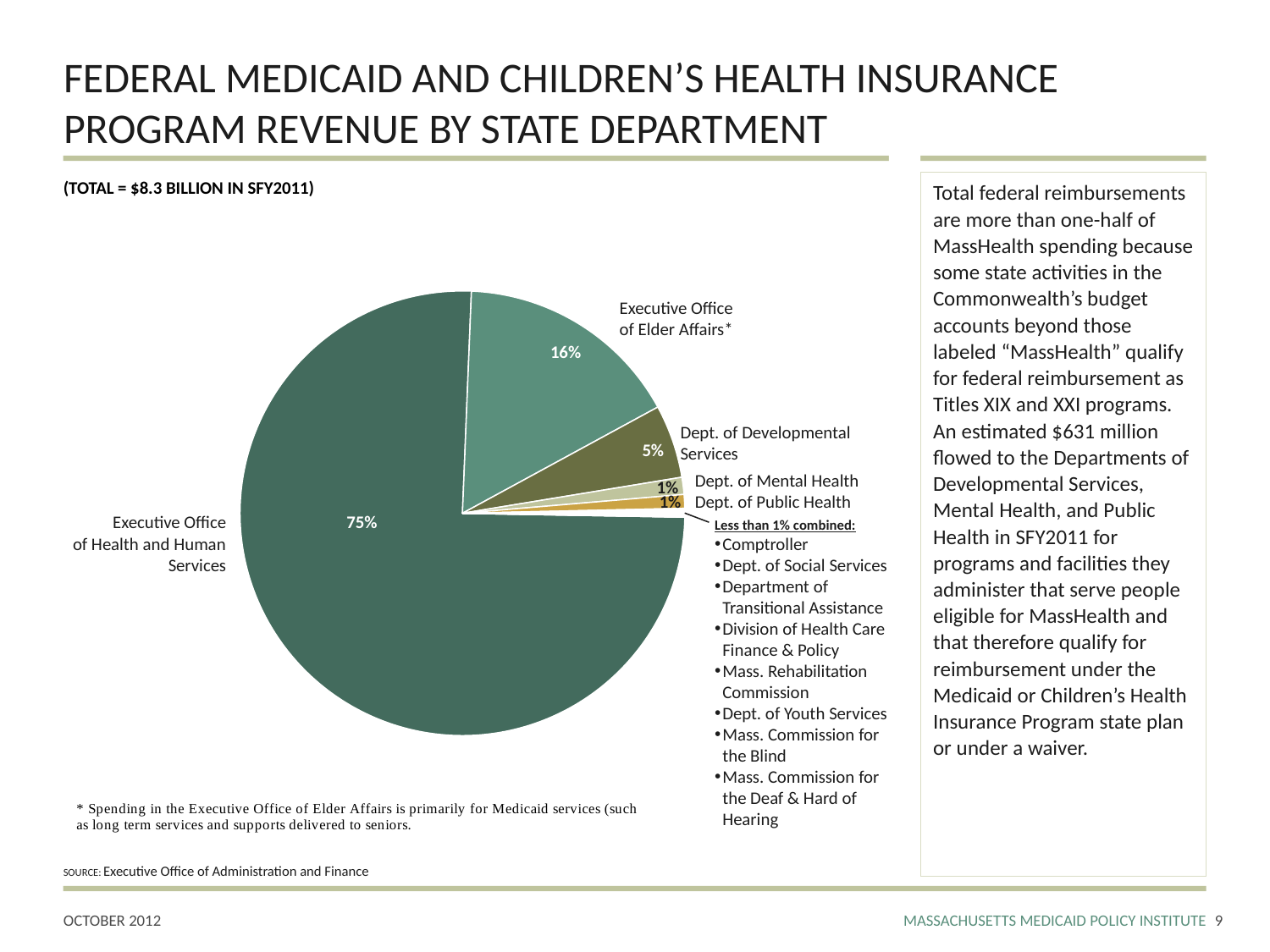
What kind of chart is shown on the slide? Pie chart Which department has the largest slice of the pie? Executive Office of Health and Human Services Which has a larger share: the Executive Office of Elder Affairs or the Dept. of Developmental Services? Executive Office of Elder Affairs What share of the pie does the Executive Office of Health and Human Services account for? 75% What is the difference in percentage points between the Executive Office of Elder Affairs and the Dept. of Developmental Services? 11 percentage points What percentage is shown for the Dept. of Developmental Services? 5% What total amount does the chart subtitle state for SFY2011? $8.3 billion How many slices of the pie have a percentage label printed on them? 5 What percentage is shown for the Dept. of Mental Health? 1% What percentage is shown for the Executive Office of Elder Affairs? 16% How many percentage points larger is the Executive Office of Health and Human Services share than the Executive Office of Elder Affairs share? 59 percentage points What source is cited for the chart? Executive Office of Administration and Finance